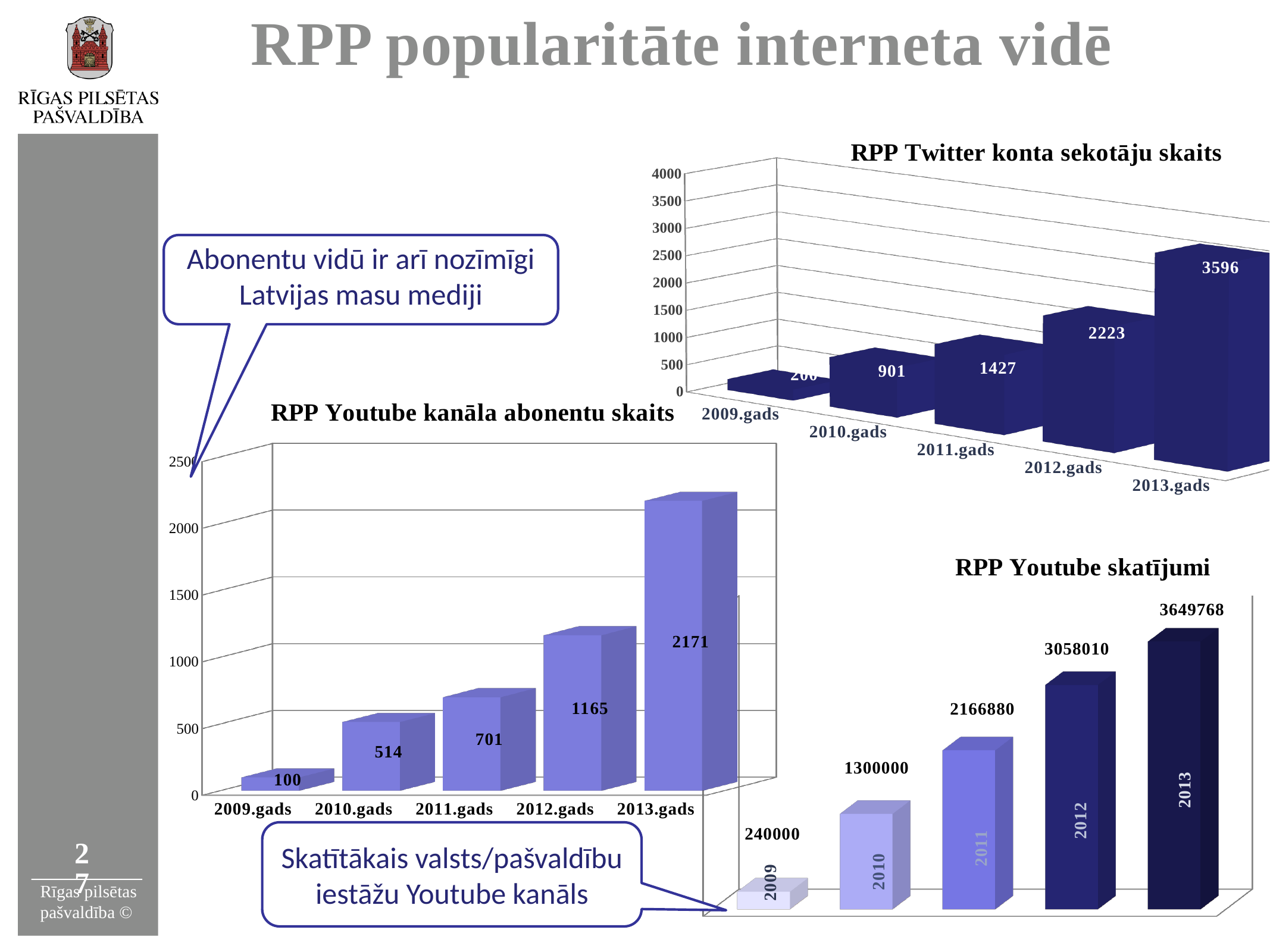
In the chart titled "RPP Youtube skatījumi", what is the value for 2011? 2166880 In the chart titled "RPP Twitter konta sekotāju skaits", what is the value for 2011.gads? 1427 In the chart titled "RPP Youtube kanāla abonentu skaits", what is the difference between the values for 2011.gads and 2010.gads? 187 In the chart titled "RPP Twitter konta sekotāju skaits", what is the value for 2013.gads? 3596 In the chart titled "RPP Youtube kanāla abonentu skaits", which year has the lowest value? 2009.gads In the chart titled "RPP Youtube skatījumi", do the values rise or fall from 2009 to 2013? rise In the chart titled "RPP Twitter konta sekotāju skaits", what is the difference between the values for 2013.gads and 2012.gads? 1373 In the chart titled "RPP Youtube kanāla abonentu skaits", what is the value for 2012.gads? 1165 What kind of chart is "RPP Youtube skatījumi"? bar chart In the chart titled "RPP Youtube kanāla abonentu skaits", how many years are shown on the x axis? 5 In the chart titled "RPP Youtube skatījumi", which year has the highest value? 2013 In the chart titled "RPP Twitter konta sekotāju skaits", is the value for 2010.gads greater or less than 1000? less